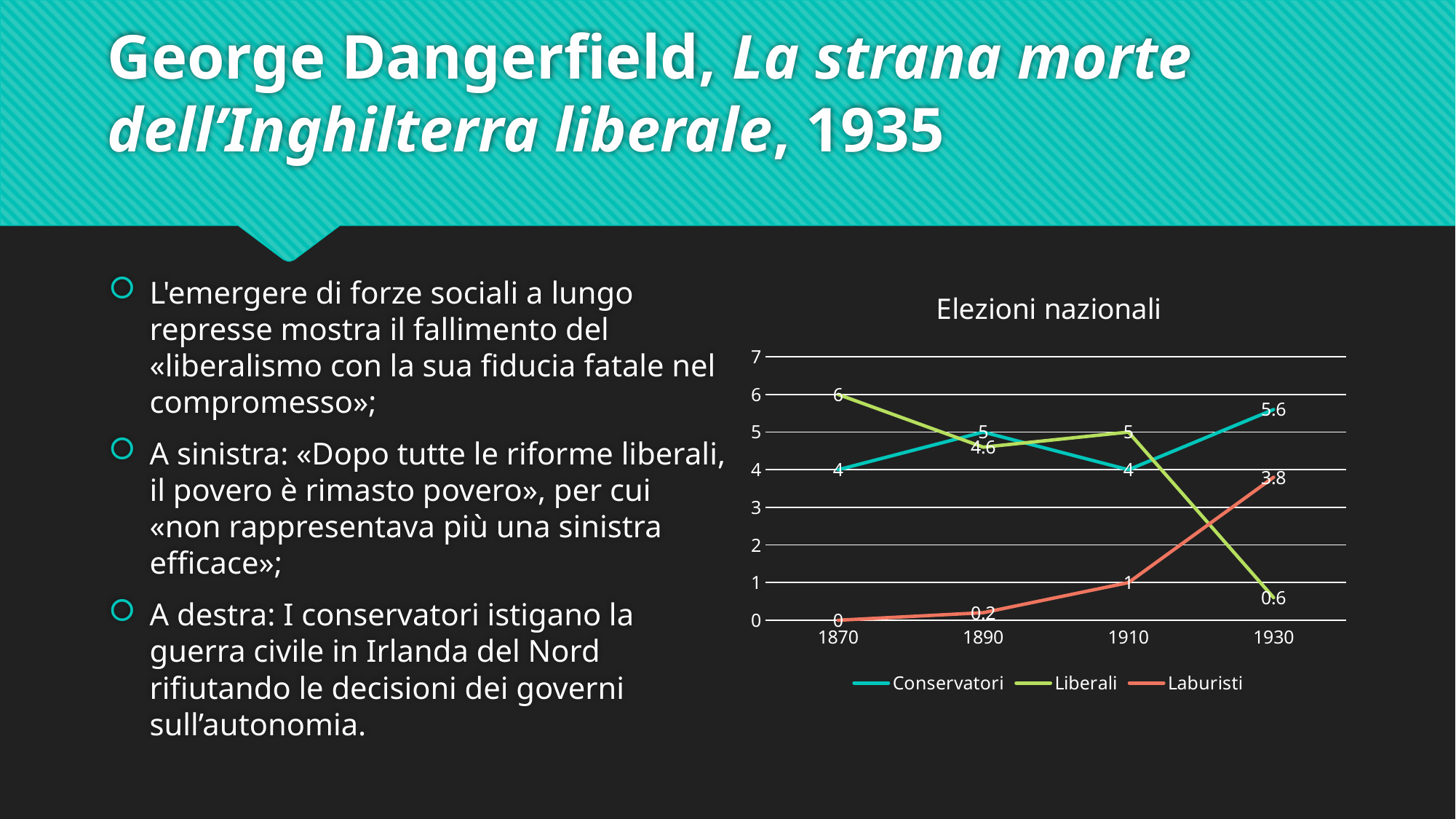
How many series does the legend list? 3 How many points are plotted along the x axis for each series? 4 What is the value for Laburisti in 1910? 1 What is the title of the chart? Elezioni nazionali What is the difference between the Liberali value in 1870 and in 1930? 5.4 What kind of chart is shown on the slide? line chart Which is larger in 1910, the Liberali value or the Conservatori value? Liberali Do the Laburisti values rise or fall from 1870 to 1930? rise In which year is the Liberali value lowest? 1930 What is the value for Conservatori in 1930? 5.6 What is the value for Liberali in 1870? 6 In which year is the Laburisti value highest? 1930